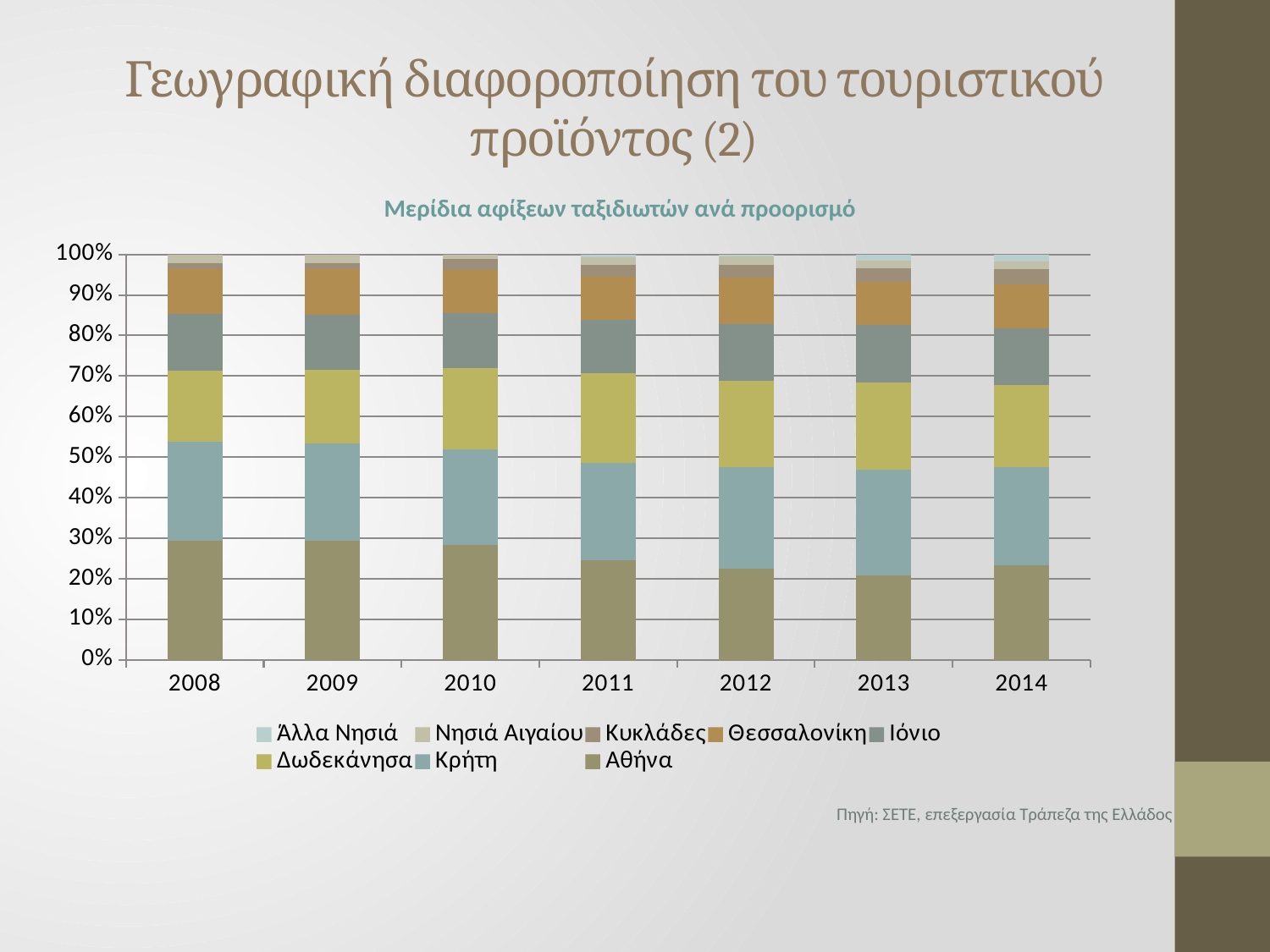
How many years are shown on the x axis of the chart? 7 Is the share for Αθήνα in 2014 greater or less than 30%? less Which series forms the bottom segment of each stacked bar? Αθήνα What kind of chart is shown on the slide? Stacked bar chart What is the total of each stacked bar in the chart? 100% What is the title of the chart? Μερίδια αφίξεων ταξιδιωτών ανά προορισμό Is the share for Αθήνα in 2013 greater or less than 30%? less Which is larger, the share for Αθήνα in 2008 or in 2013? 2008 How many series does the chart's legend list? 8 Is the share for Αθήνα in 2008 greater or less than 20%? greater Does the share for Αθήνα rise or fall from 2008 to 2013? Fall